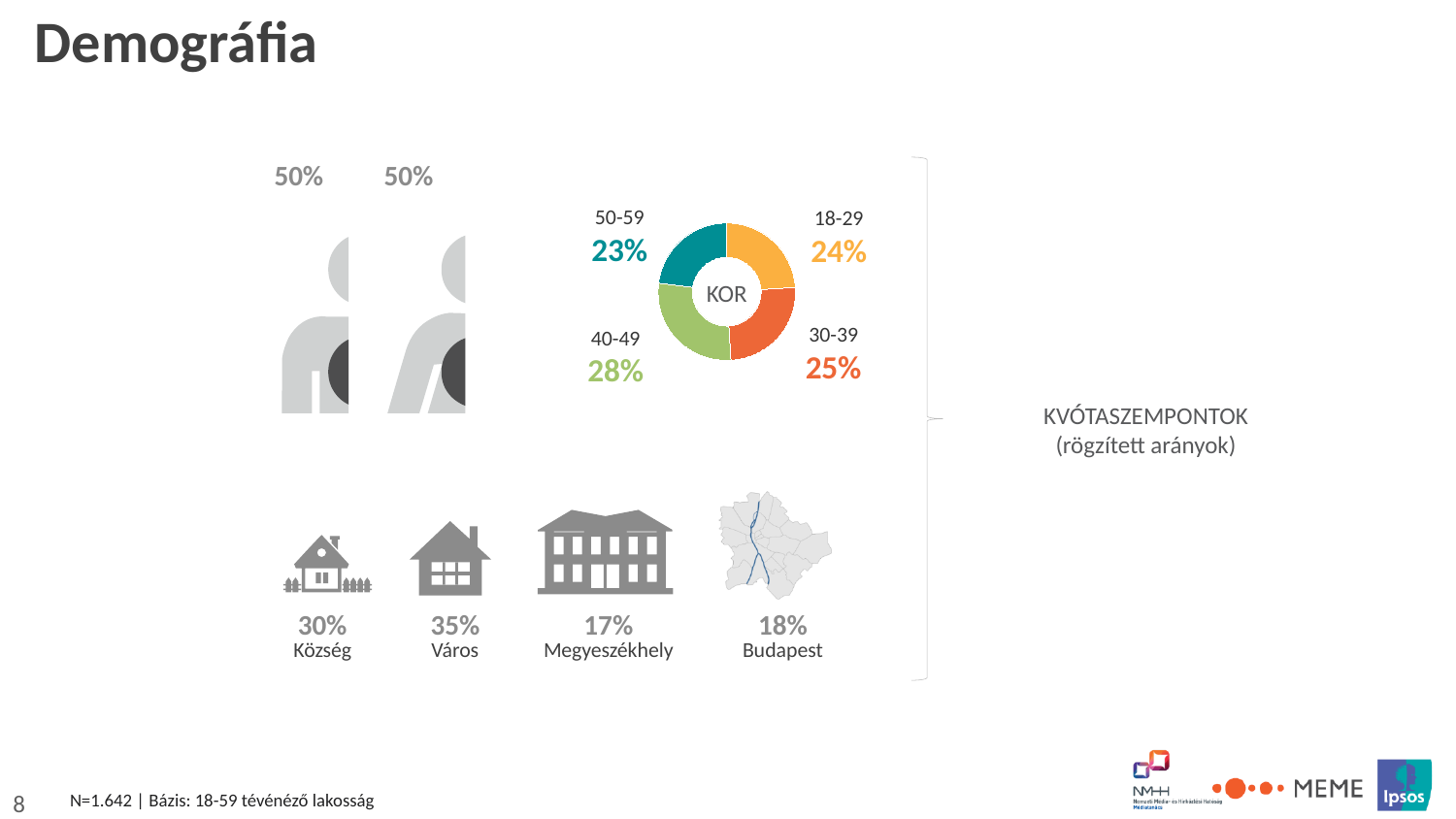
What type of chart is the KOR chart? Donut chart In the KOR chart, what share is shown for the 50-59 age group? 23% In the KOR chart, which age group has the largest share? 40-49 In the KOR chart, what is the difference in percentage points between the 40-49 and 50-59 age groups? 5 percentage points In the KOR chart, what colour is the slice for the 18-29 age group? Orange What label is written in the centre of the donut chart? KOR In the KOR chart, which is larger: the share for 18-29 or the share for 30-39? 30-39 In the KOR chart, which age group has the smallest share? 50-59 In the KOR chart, what share is shown for the 18-29 age group? 24% In the KOR chart, what share is shown for the 30-39 age group? 25% In the KOR chart, what share is shown for the 40-49 age group? 28% How many age groups are shown in the KOR chart? 4